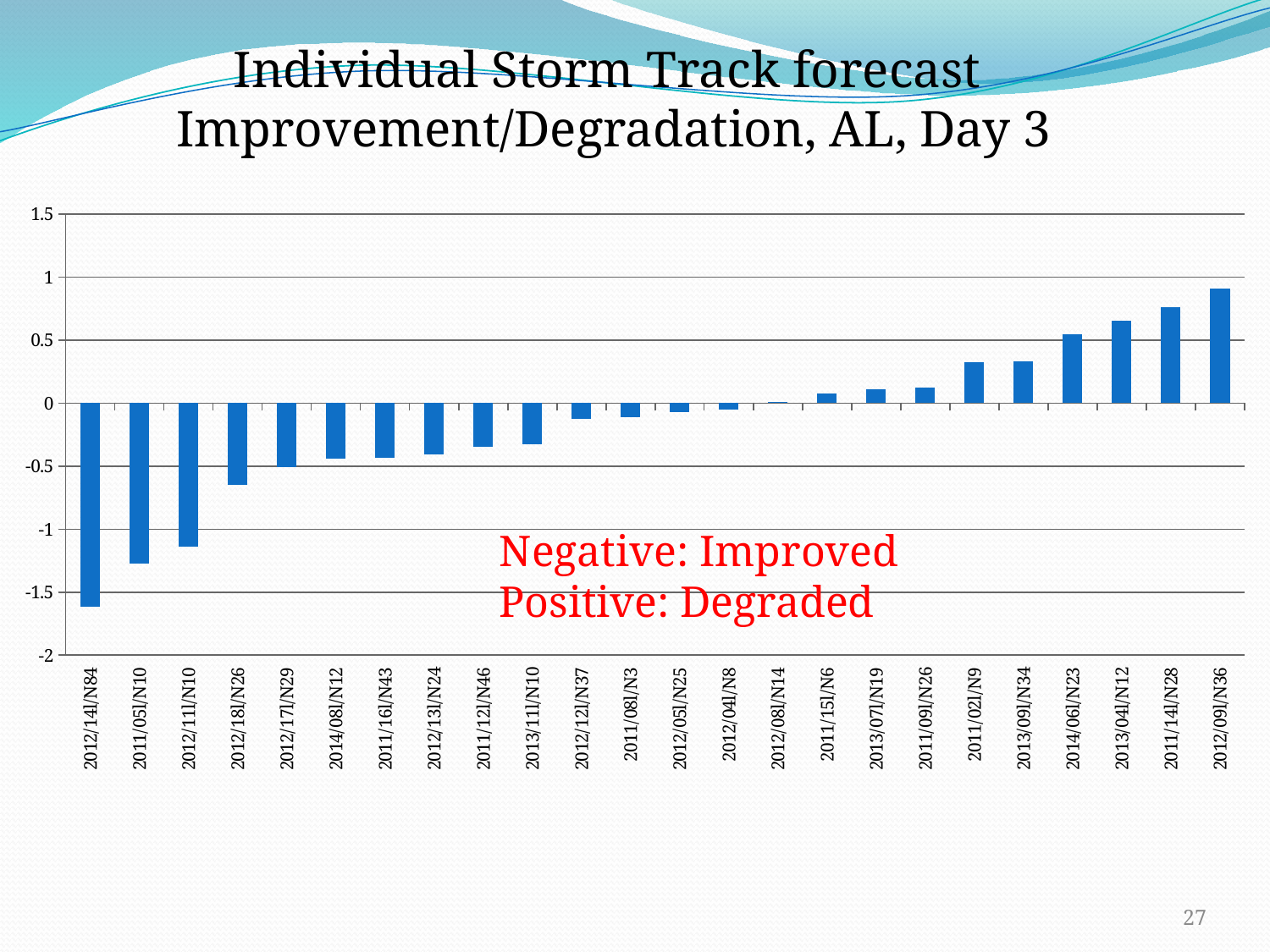
Is the value for 2011/02l/N9 greater or less than 0.5? less According to the red annotation on the chart, what does a negative value indicate? Improved Is the value for 2011/05l/N10 greater or less than -1? less Do the values generally rise or fall moving from left to right along the x axis? rise How many storms (categories) are plotted on the x axis? 24 Which storm has the highest (most positive) value? 2012/09l/N36 Which storm has the lowest (most negative) value? 2012/14l/N84 Is the value for 2012/09l/N36 greater or less than 0.5? greater What kind of chart is shown on the slide? bar chart Which has the larger value, 2011/14l/N28 or 2013/04l/N12? 2011/14l/N28